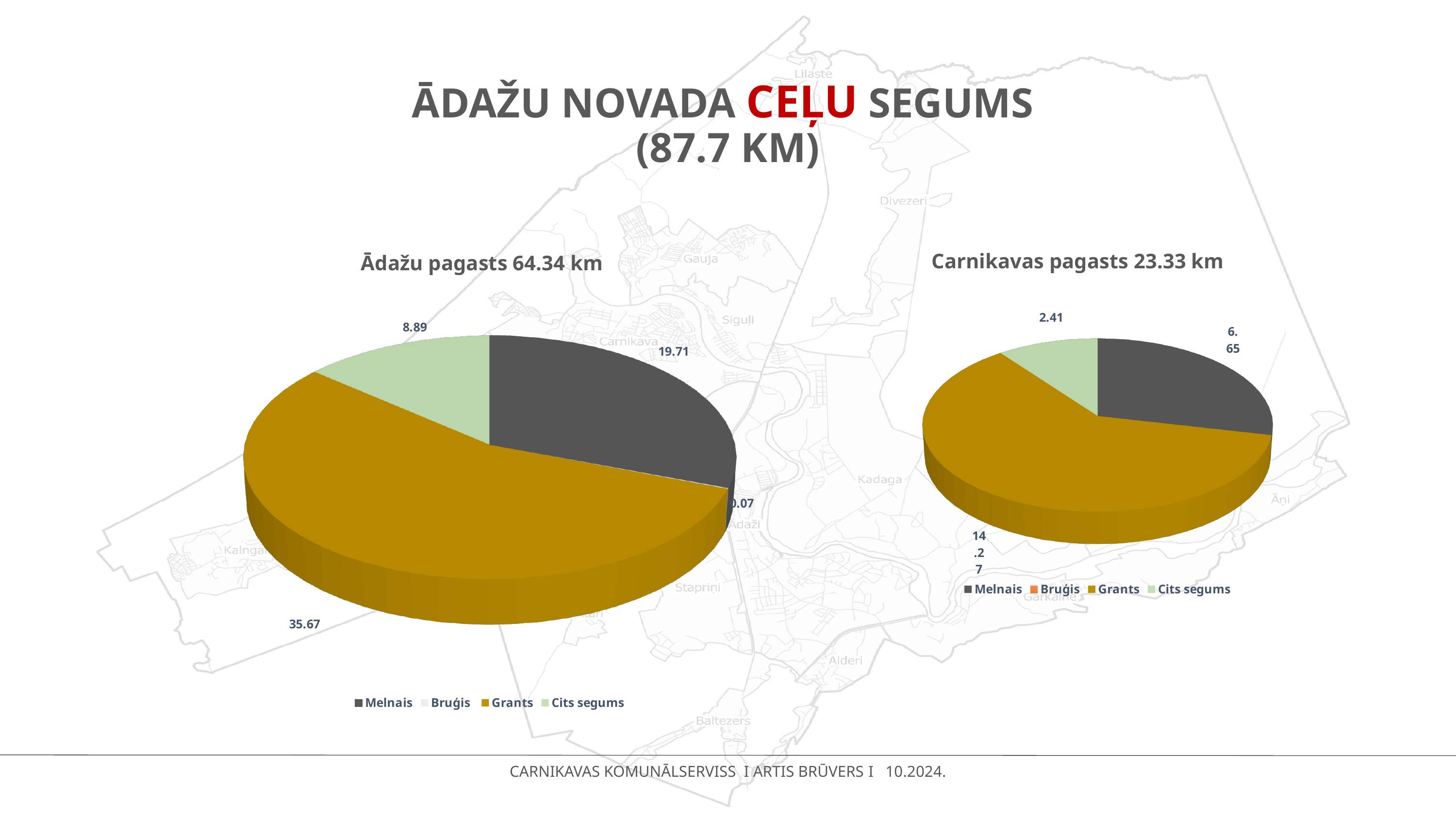
What type of chart is used for Ādažu pagasts 64.34 km? Pie chart How many entries does the legend of the Carnikavas pagasts 23.33 km chart list? 4 In the Ādažu pagasts 64.34 km chart, what is the value for Melnais? 19.71 In the Carnikavas pagasts 23.33 km chart, which is larger, Melnais or Cits segums? Melnais In the Ādažu pagasts 64.34 km chart, which category has the largest slice? Grants In the Carnikavas pagasts 23.33 km chart, what is the value for Melnais? 6.65 In the Ādažu pagasts 64.34 km chart, what is the difference between Grants and Melnais? 15.96 In the Ādažu pagasts 64.34 km chart, what is the value for Grants? 35.67 In the Carnikavas pagasts 23.33 km chart, what is the value for Cits segums? 2.41 What is the title of the chart on the left of the slide? Ādažu pagasts 64.34 km In the Carnikavas pagasts 23.33 km chart, what is the value for Grants? 14.27 In the Ādažu pagasts 64.34 km chart, what is the value for Cits segums? 8.89